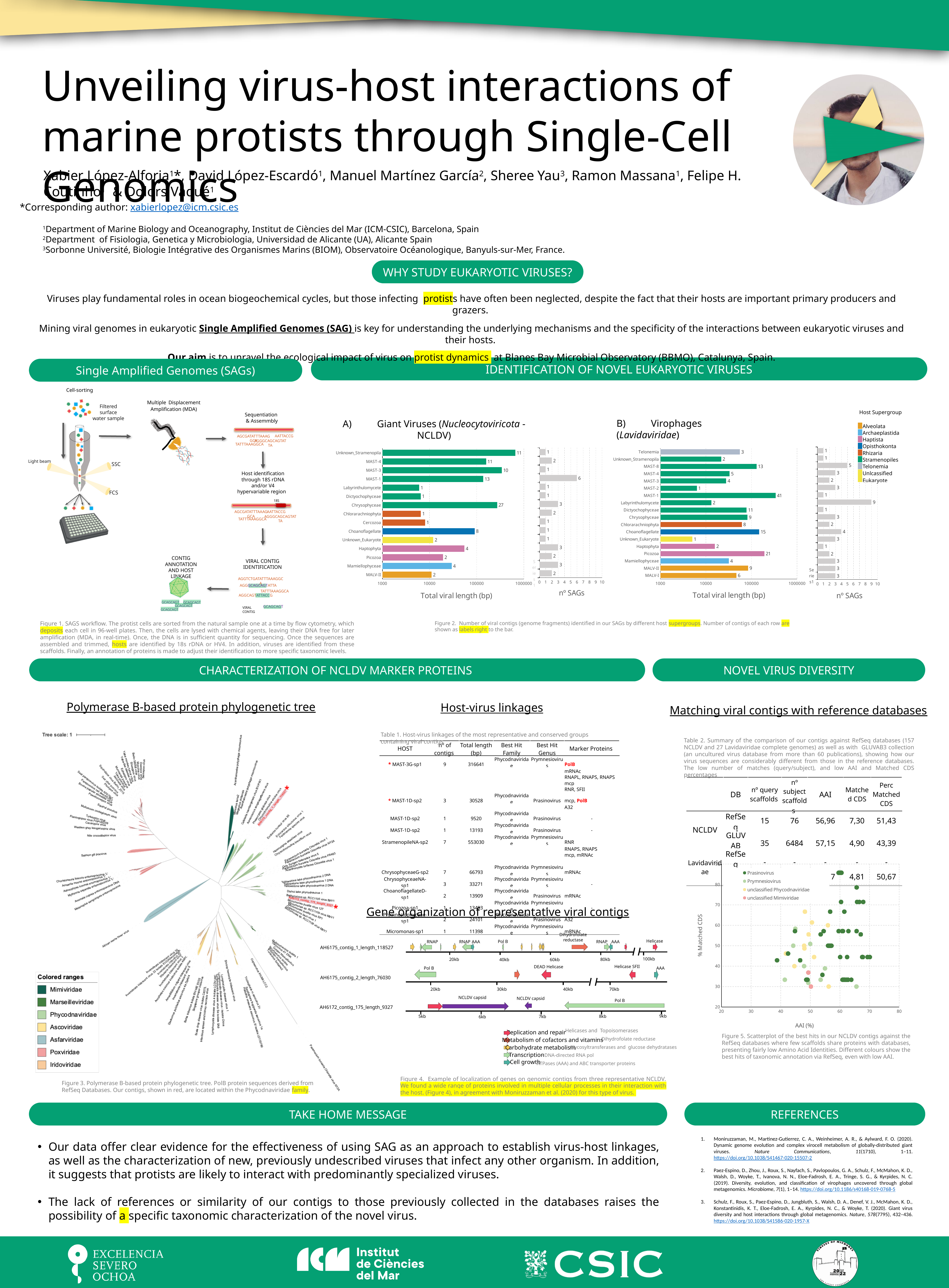
What kind of chart is Figure 5 (Matching viral contigs with reference databases)? Scatter plot How many series does the legend of Figure 5 list? 4 In Figure 2A (Giant Viruses, NCLDV), what number is labelled on the bar for MAST-1? 13 In Figure 2B (Virophages, Lavidaviridae), what number is labelled on the bar for Choanoflagellate? 15 In Figure 2A (Giant Viruses, NCLDV), which host group has the highest labelled value? Chrysophyceae In Figure 2B (Virophages, Lavidaviridae), what is the nº SAGs value shown for Dictyochophyceae? 1 In Figure 2B (Virophages, Lavidaviridae), which host group has the highest labelled value? MAST-1 In Figure 2A (Giant Viruses, NCLDV), what is the nº SAGs value shown for MAST-1? 6 In Figure 2A (Giant Viruses, NCLDV), what number is labelled on the bar for Chrysophyceae? 27 In Figure 2A (Giant Viruses, NCLDV), what is the difference between the labelled values for Chrysophyceae and Choanoflagellate? 19 In Figure 2B (Virophages, Lavidaviridae), what number is labelled on the bar for Picozoa? 21 In Figure 2B (Virophages, Lavidaviridae), which has a larger labelled value, Dictyochophyceae or Chrysophyceae? Dictyochophyceae